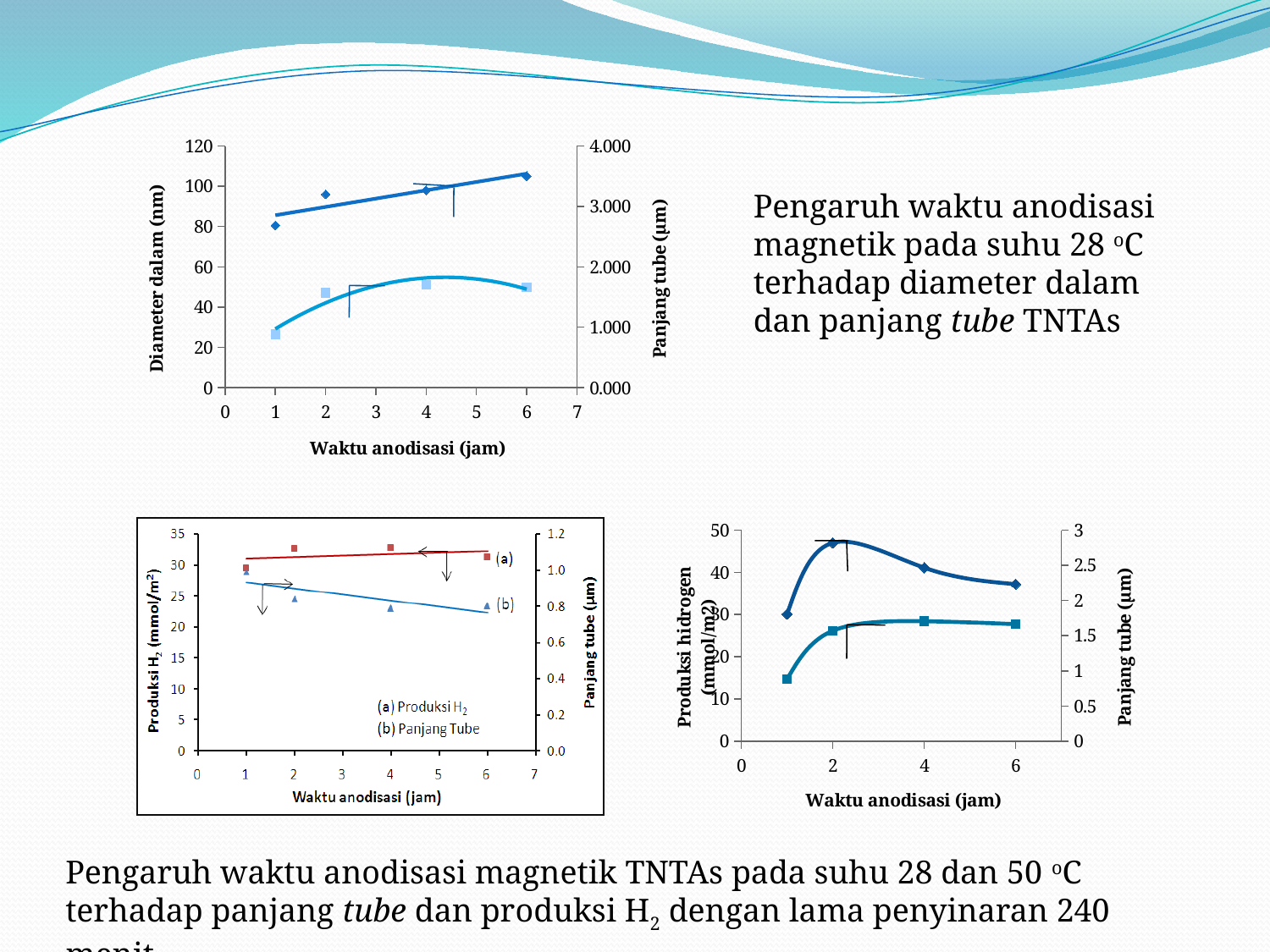
In the bottom-left chart, does the (b) Panjang Tube series rise or fall as waktu anodisasi increases? fall In the top chart, how many data points are plotted for the Diameter dalam series? 4 In the top chart, is the Panjang tube value at 1 jam greater or less than 1.000 µm? less In the top chart, what kind of chart is used to show diameter dalam and panjang tube against waktu anodisasi? scatter chart with trend lines In the top chart, what is the title of the x axis? Waktu anodisasi (jam) In the bottom-right chart, at which waktu anodisasi is Produksi hidrogen highest? 2 jam In the bottom-right chart, is the Produksi hidrogen value at 1 jam greater or less than 40 mmol/m²? less In the top chart, is the Diameter dalam value at 6 jam greater or less than 100 nm? greater In the bottom-left chart, how many series are listed in the legend? 2 In the top chart, does the Diameter dalam series rise or fall as waktu anodisasi increases from 1 to 6 jam? rise